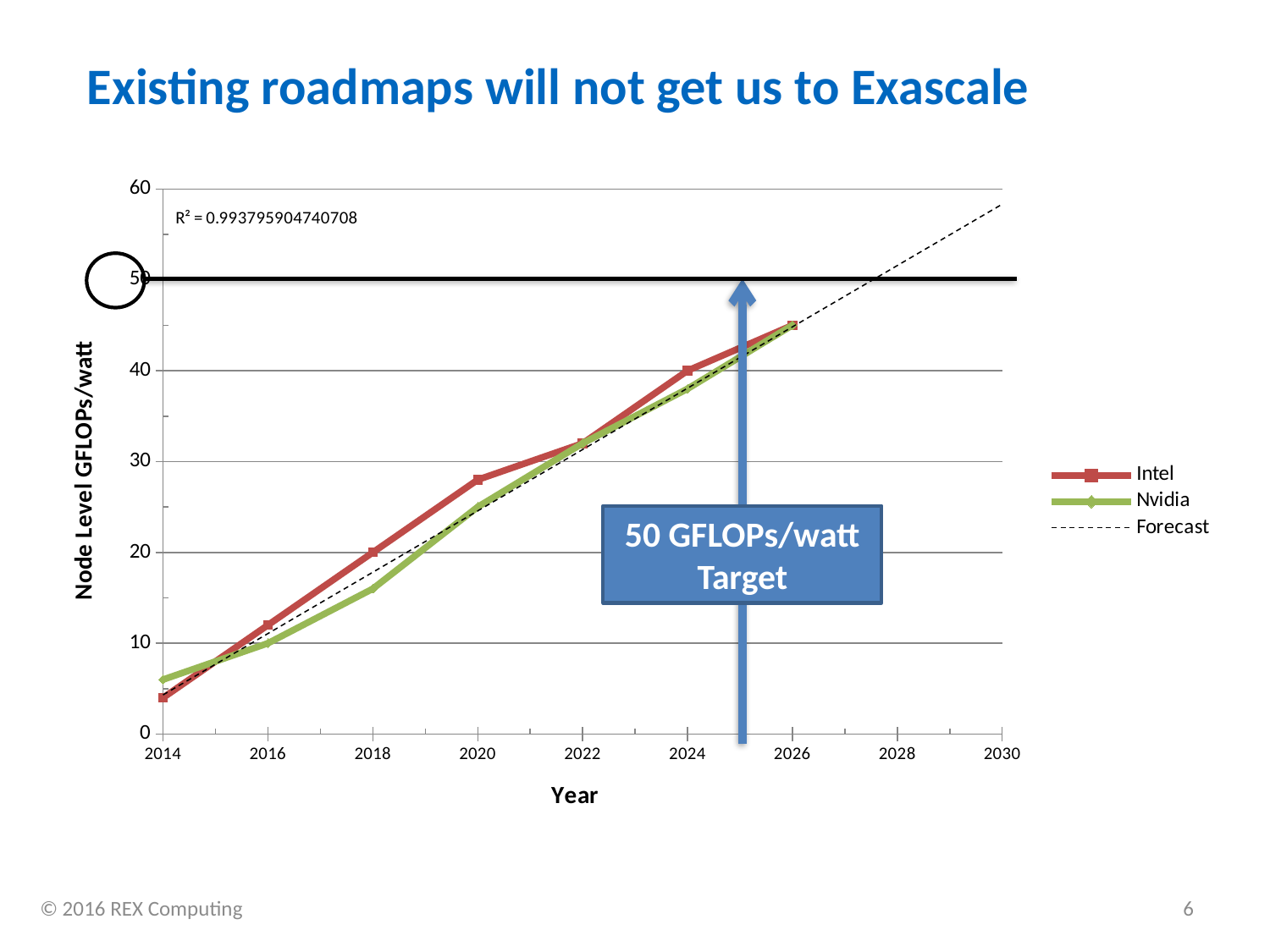
Is the Intel value for 2020 greater or less than 20? greater Is the Nvidia value for 2018 greater or less than 20? less Is the Intel value for 2024 greater or less than 30? greater What kind of chart is shown on the slide? line chart What is the label of the y axis? Node Level GFLOPs/watt Which series are listed in the legend? Intel, Nvidia, Forecast Do the Intel values rise or fall from 2014 to 2026? rise In 2018, which series has the larger value, Intel or Nvidia? Intel How many series does the legend list? 3 In which year does the Intel series reach its highest value? 2026 In 2014, which series has the larger value, Intel or Nvidia? Nvidia